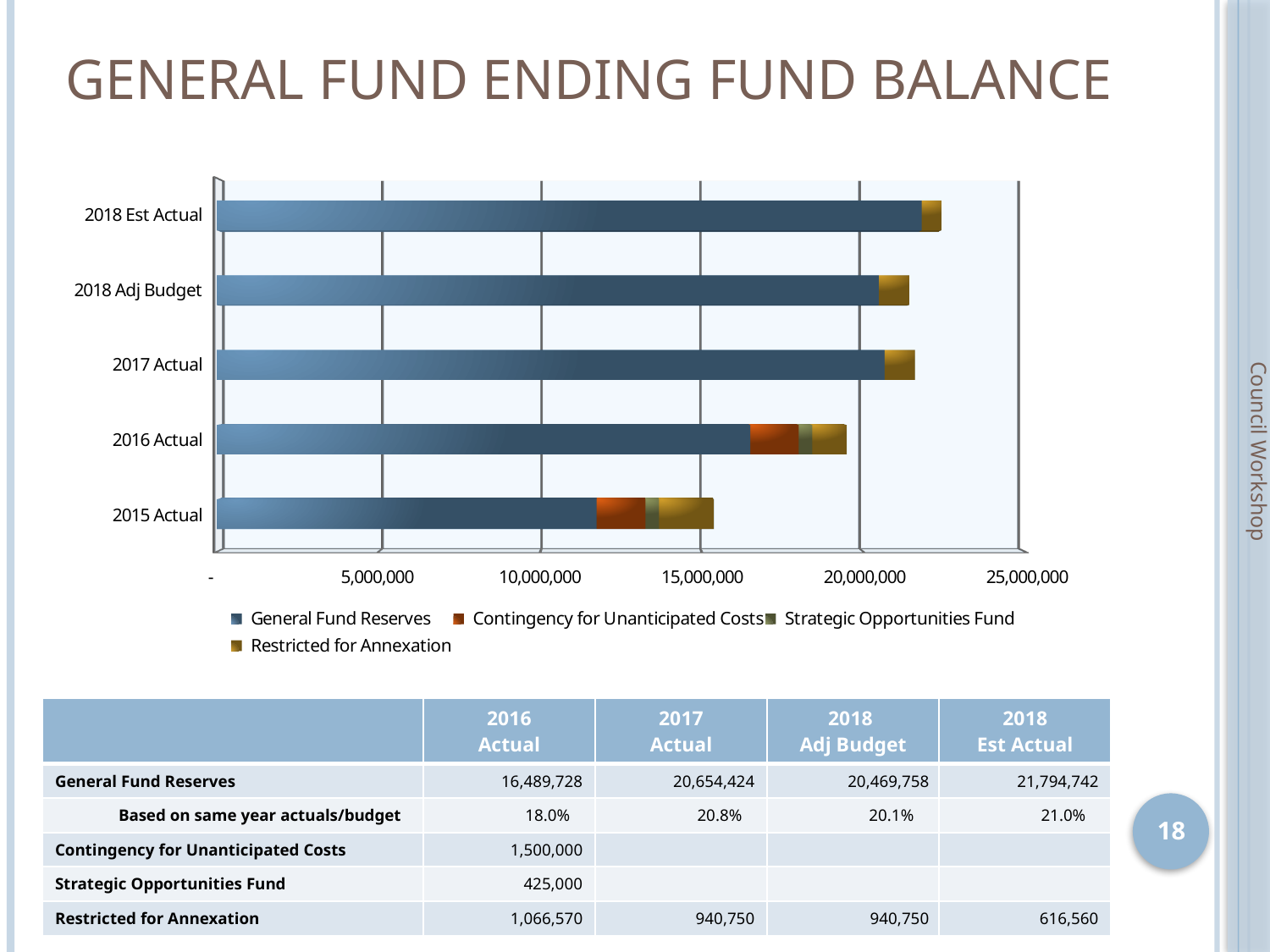
Which is larger, the General Fund Reserves for 2017 Actual or for 2018 Adj Budget? 2017 Actual What is the difference between the General Fund Reserves for 2018 Est Actual and 2018 Adj Budget? 1,324,984 How many categories (years/budget labels) are plotted on the chart? 5 What is the total of the stacked bar for 2017 Actual? 21,595,174 What is the Contingency for Unanticipated Costs value for 2016 Actual? 1,500,000 What kind of chart is shown on the slide? Stacked bar chart What is the General Fund Reserves value for 2018 Est Actual? 21,794,742 Which category has the lowest General Fund Reserves value? 2015 Actual What is the Restricted for Annexation value for 2016 Actual? 1,066,570 How many series does the chart legend list? 4 Is the General Fund Reserves value for 2015 Actual greater or less than 15,000,000? less Which category has the highest General Fund Reserves value? 2018 Est Actual